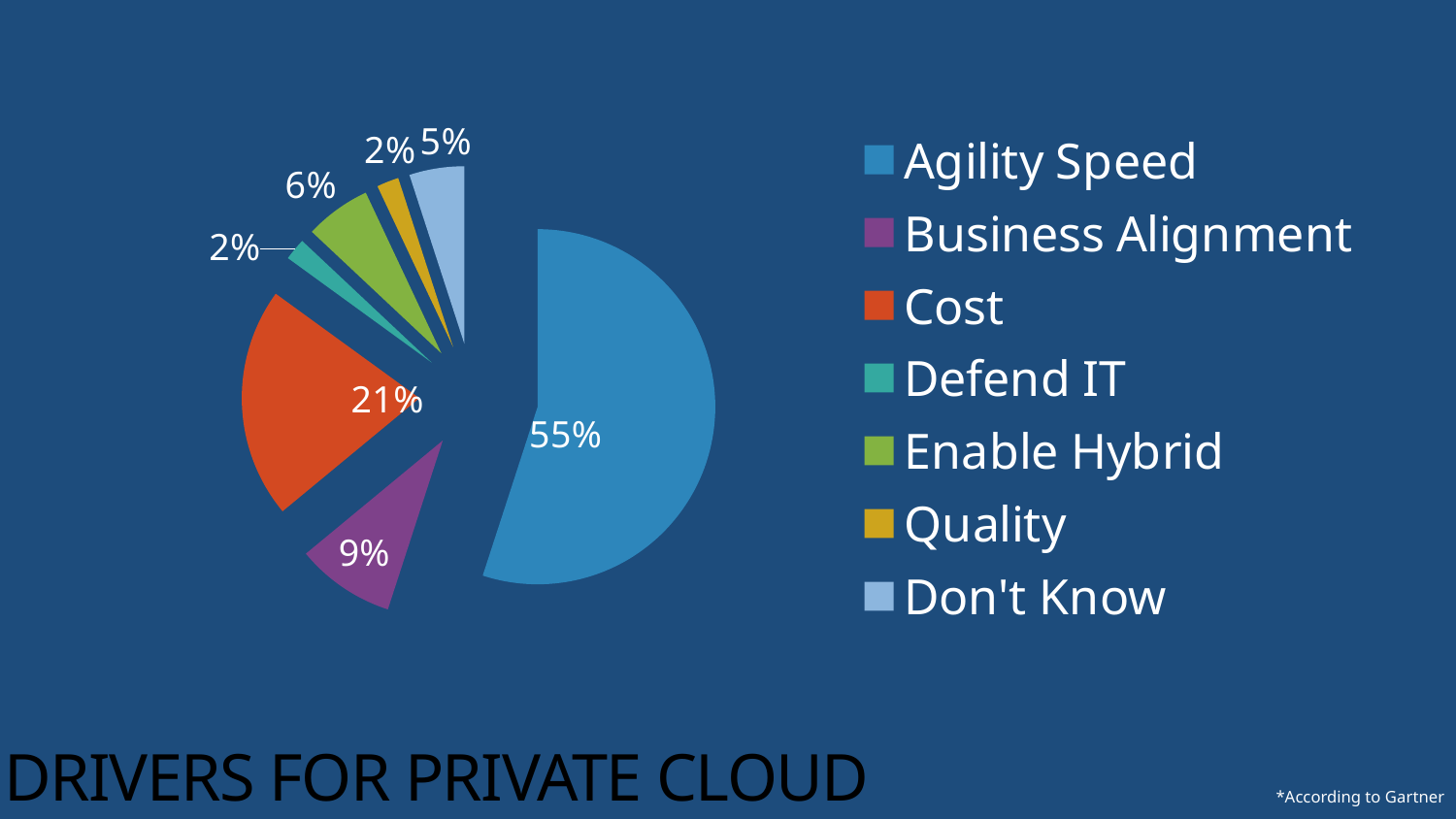
What kind of chart is shown on the slide? pie chart What is the value for Business Alignment? 9% How many categories does the legend list? 7 What is the value for Enable Hybrid? 6% What is the title of the slide containing the chart? DRIVERS FOR PRIVATE CLOUD What is the value for Cost? 21% Which category has the largest slice of the pie? Agility Speed Which is larger, the value for Cost or the value for Business Alignment? Cost What share of the pie does Agility Speed have? 55% What is the difference between the values for Agility Speed and Cost? 34% What is the value for Don't Know? 5% What colour is the slice for Cost? red